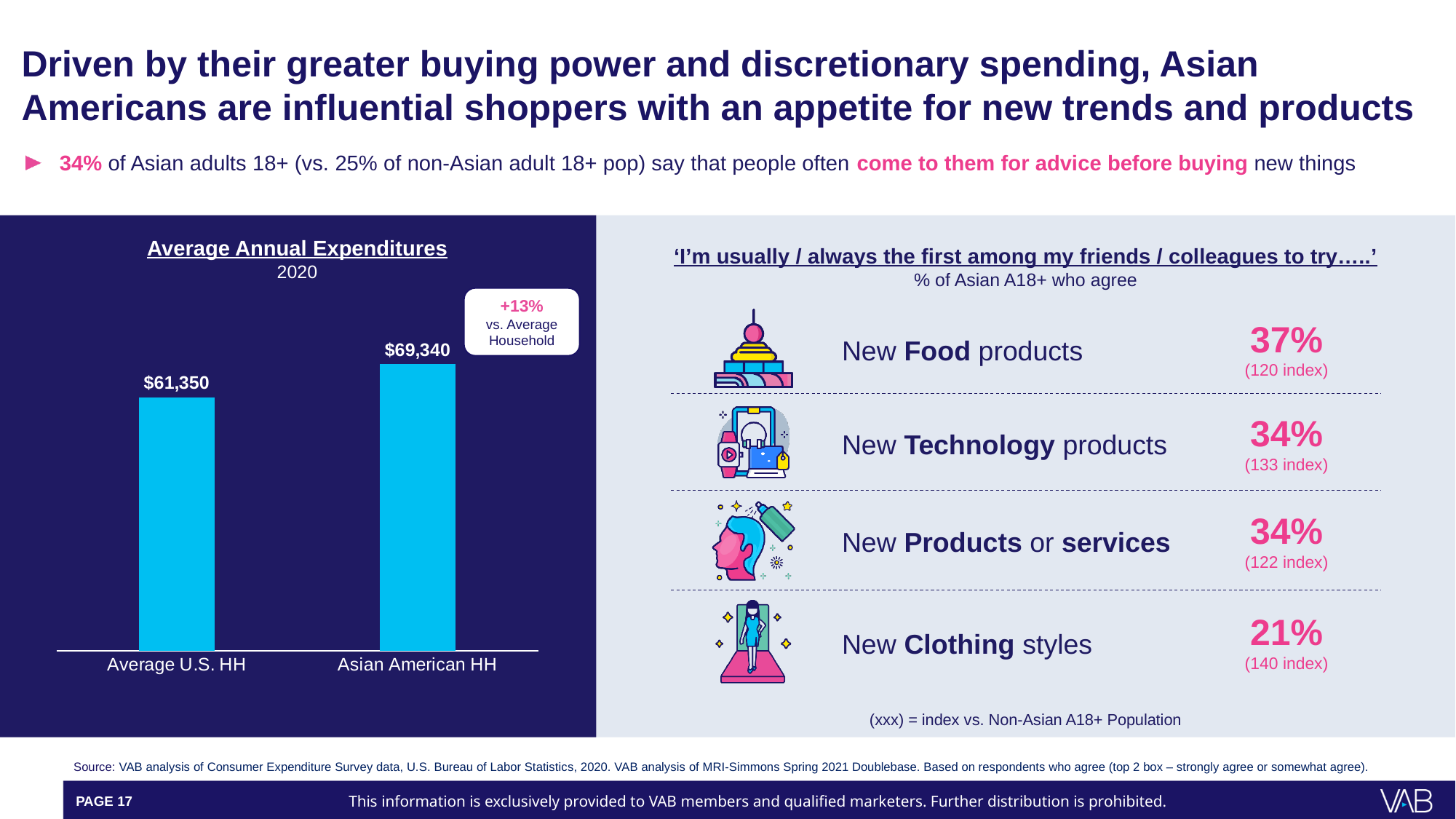
In the Average Annual Expenditures chart, which category has the highest value? Asian American HH In the Average Annual Expenditures chart, do the values rise or fall from left to right? Rise What kind of chart is the Average Annual Expenditures chart? Bar chart How many categories are shown in the Average Annual Expenditures chart? 2 According to the annotation on the Average Annual Expenditures chart, by what percentage does the Asian American HH value exceed the average household? +13% In the Average Annual Expenditures chart, what is the value for Average U.S. HH? $61,350 What year does the Average Annual Expenditures chart cover? 2020 In the Average Annual Expenditures chart, what is the difference between the Asian American HH value and the Average U.S. HH value? $7,990 In the Average Annual Expenditures chart, which is larger: the value for Average U.S. HH or the value for Asian American HH? Asian American HH In the Average Annual Expenditures chart, what is the value for Asian American HH? $69,340 In the Average Annual Expenditures chart, which category has the lowest value? Average U.S. HH